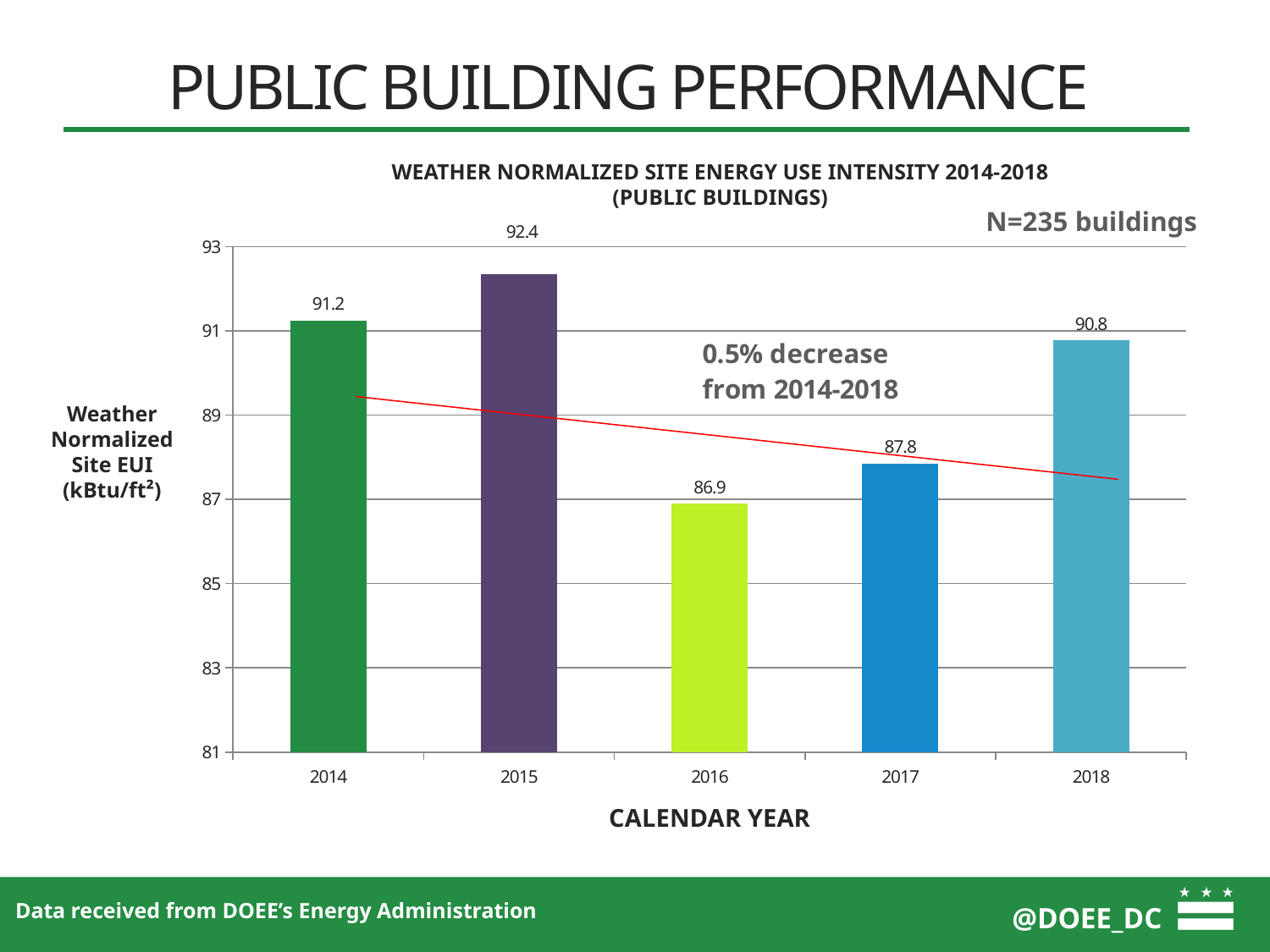
Which year has a higher value, 2017 or 2018? 2018 How many calendar years are shown on the chart? 5 What is the weather normalized site EUI for 2014? 91.2 What is the difference between the 2015 and 2016 values? 5.5 What is the weather normalized site EUI for 2016? 86.9 How many buildings does the chart note say are included (N)? 235 Is the value for 2017 greater or less than 89? less What kind of chart is shown on the slide? bar chart Which calendar year has the highest weather normalized site EUI? 2015 Which calendar year has the lowest weather normalized site EUI? 2016 What is the difference between the 2014 and 2018 values? 0.4 What is the weather normalized site EUI for 2018? 90.8